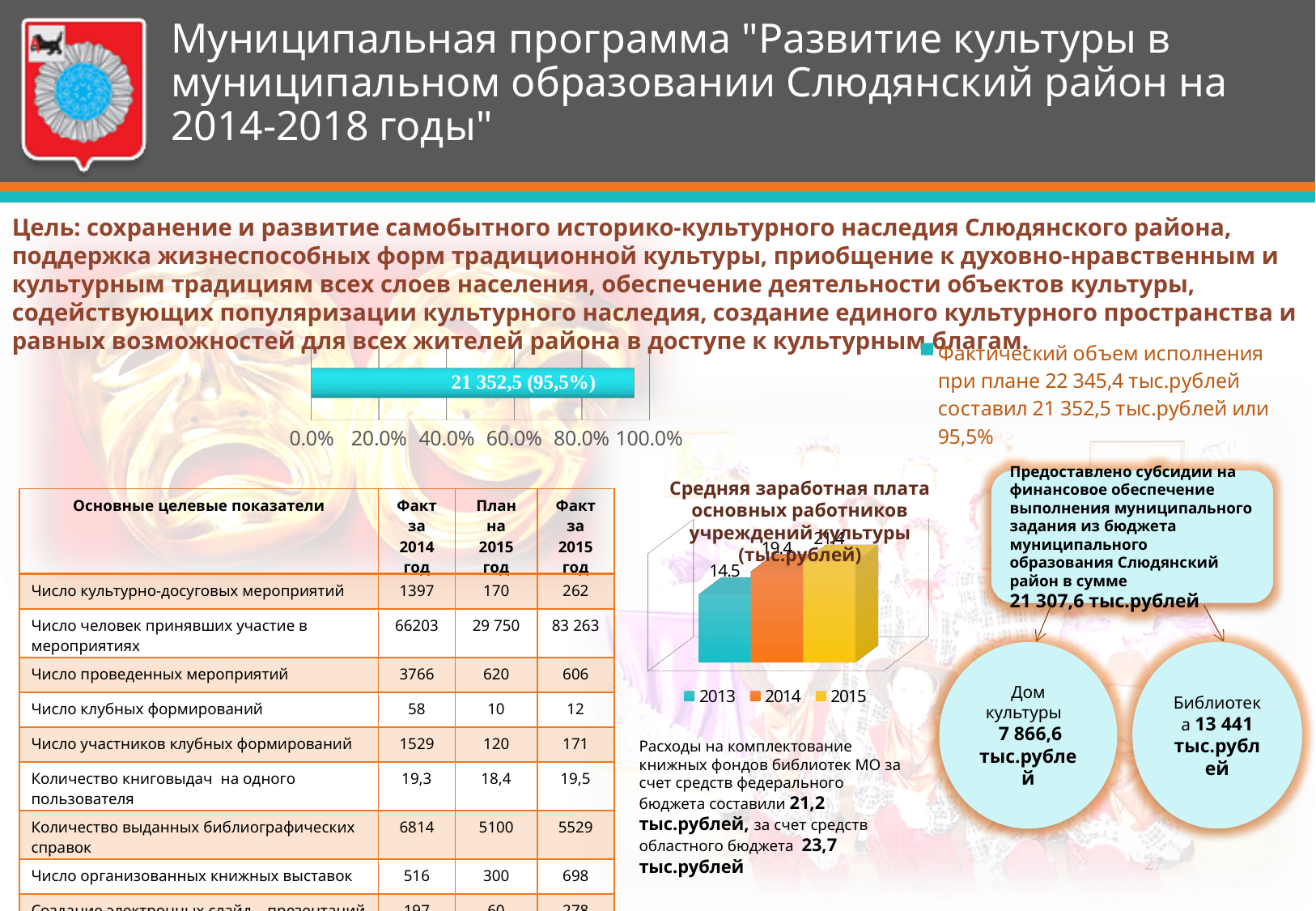
On the horizontal bar chart at the top of the slide, what is the data label printed on the bar? 21 352,5 (95,5%) On the chart titled "Средняя заработная плата основных работников учреждений культуры (тыс.рублей)", do the values rise or fall from 2013 to 2015? rise On the chart titled "Средняя заработная плата основных работников учреждений культуры (тыс.рублей)", which year has the highest value? 2015 On the chart titled "Средняя заработная плата основных работников учреждений культуры (тыс.рублей)", what is the value for 2014? 19.4 On the chart titled "Средняя заработная плата основных работников учреждений культуры (тыс.рублей)", what is the value for 2015? 21.4 What kind of chart is the chart titled "Средняя заработная плата основных работников учреждений культуры (тыс.рублей)"? bar chart On the horizontal bar chart at the top of the slide, what is the maximum value shown on the x axis? 100.0% On the chart titled "Средняя заработная плата основных работников учреждений культуры (тыс.рублей)", which year has the lowest value? 2013 On the chart titled "Средняя заработная плата основных работников учреждений культуры (тыс.рублей)", which is larger, the value for 2014 or for 2013? 2014 On the chart titled "Средняя заработная плата основных работников учреждений культуры (тыс.рублей)", what is the difference between the 2015 and 2013 values? 6.9 On the chart titled "Средняя заработная плата основных работников учреждений культуры (тыс.рублей)", how many series does the legend list? 3 On the chart titled "Средняя заработная плата основных работников учреждений культуры (тыс.рублей)", what is the value for 2013? 14.5